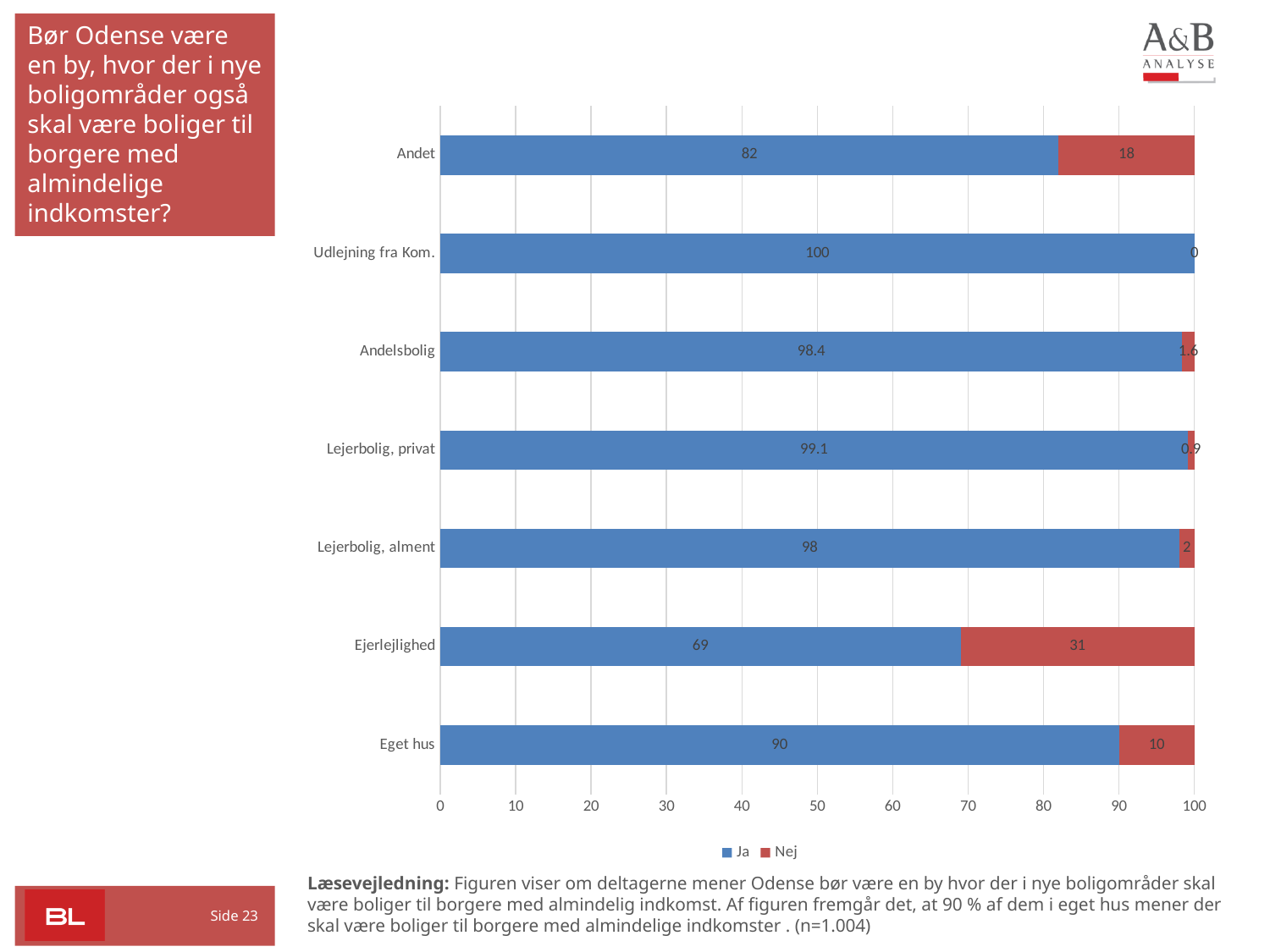
What is the 'Nej' value for Andet? 18 What is the 'Ja' value for Andelsbolig? 98.4 What is the difference between the 'Ja' values for Eget hus and Ejerlejlighed? 21 Which is larger, the 'Nej' value for Andet or the 'Nej' value for Eget hus? Andet What is the total of the stacked bar for Lejerbolig, alment? 100 Which category has the highest 'Ja' value? Udlejning fra Kom. How many series does the legend list? 2 Which category has the lowest 'Ja' value? Ejerlejlighed What is the 'Ja' value for Eget hus? 90 How many categories are shown on the y axis? 7 What kind of chart is shown on the slide? Stacked bar chart What is the 'Nej' value for Ejerlejlighed? 31